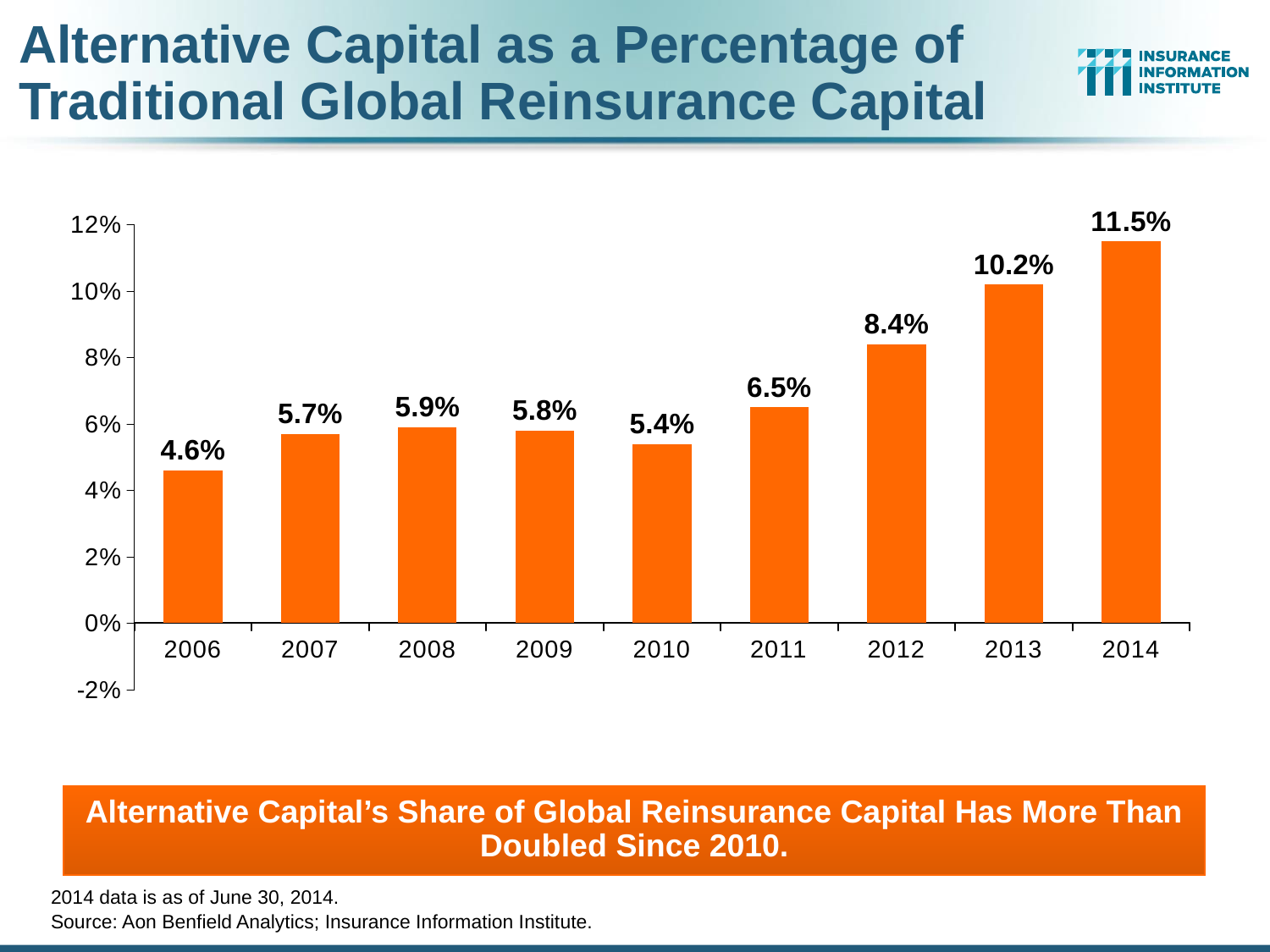
Is the value for 2012 greater or less than 8%? greater What is the difference between the values for 2014 and 2010? 6.1% Which year has the lowest value? 2006 What kind of chart is shown on the slide? Bar chart What is the difference between the values for 2013 and 2012? 1.8% What is the value for 2006? 4.6% How many years are shown on the x axis? 9 What is the value for 2014? 11.5% Do the values rise or fall from 2010 to 2014? Rise What is the value for 2010? 5.4% Which year has the highest value? 2014 Which is larger, the value for 2008 or the value for 2011? 2011